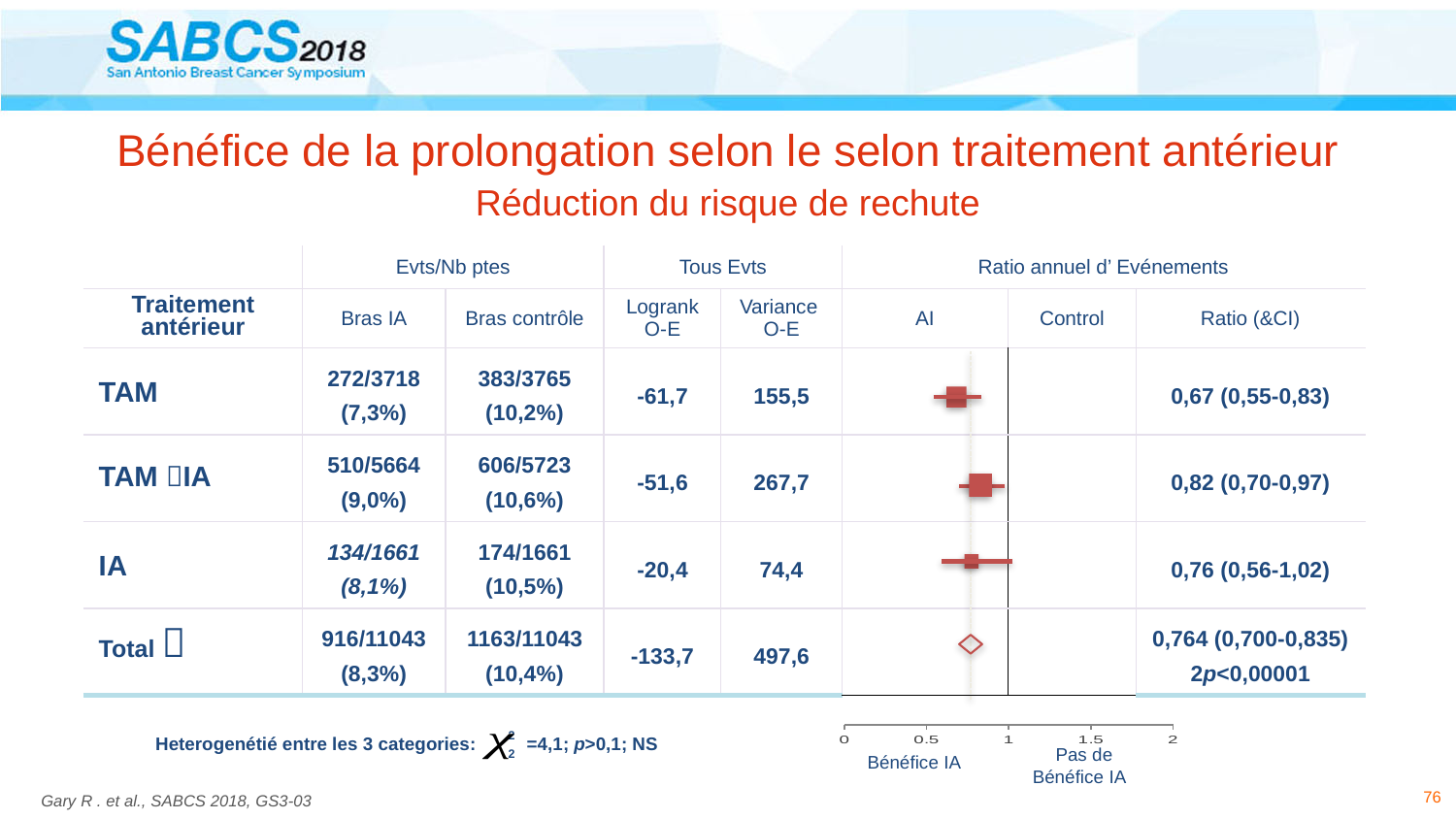
What is the difference between the event ratio of the TAM→IA group and that of the TAM group? 0,15 What is the ratio (with CI) plotted for the TAM→IA prior-treatment group? 0,82 (0,70-0,97) Which of the three prior-treatment groups has the highest event ratio? TAM→IA How many rows (including the Total) are plotted in the forest plot? 4 What is the ratio (with CI) plotted for the TAM prior-treatment group? 0,67 (0,55-0,83) Which has the larger event ratio, the TAM group or the IA group? IA Is the event ratio for the TAM group greater or less than 1? less What is the overall (Total) ratio with its confidence interval shown in the forest plot? 0,764 (0,700-0,835) What label appears under the left side of the forest plot axis (below 0.5)? Bénéfice IA Which of the three prior-treatment groups has the lowest event ratio? TAM What is the ratio (with CI) plotted for the IA prior-treatment group? 0,76 (0,56-1,02) What kind of chart is shown in the 'Ratio annuel d'Evénements' section? Forest plot